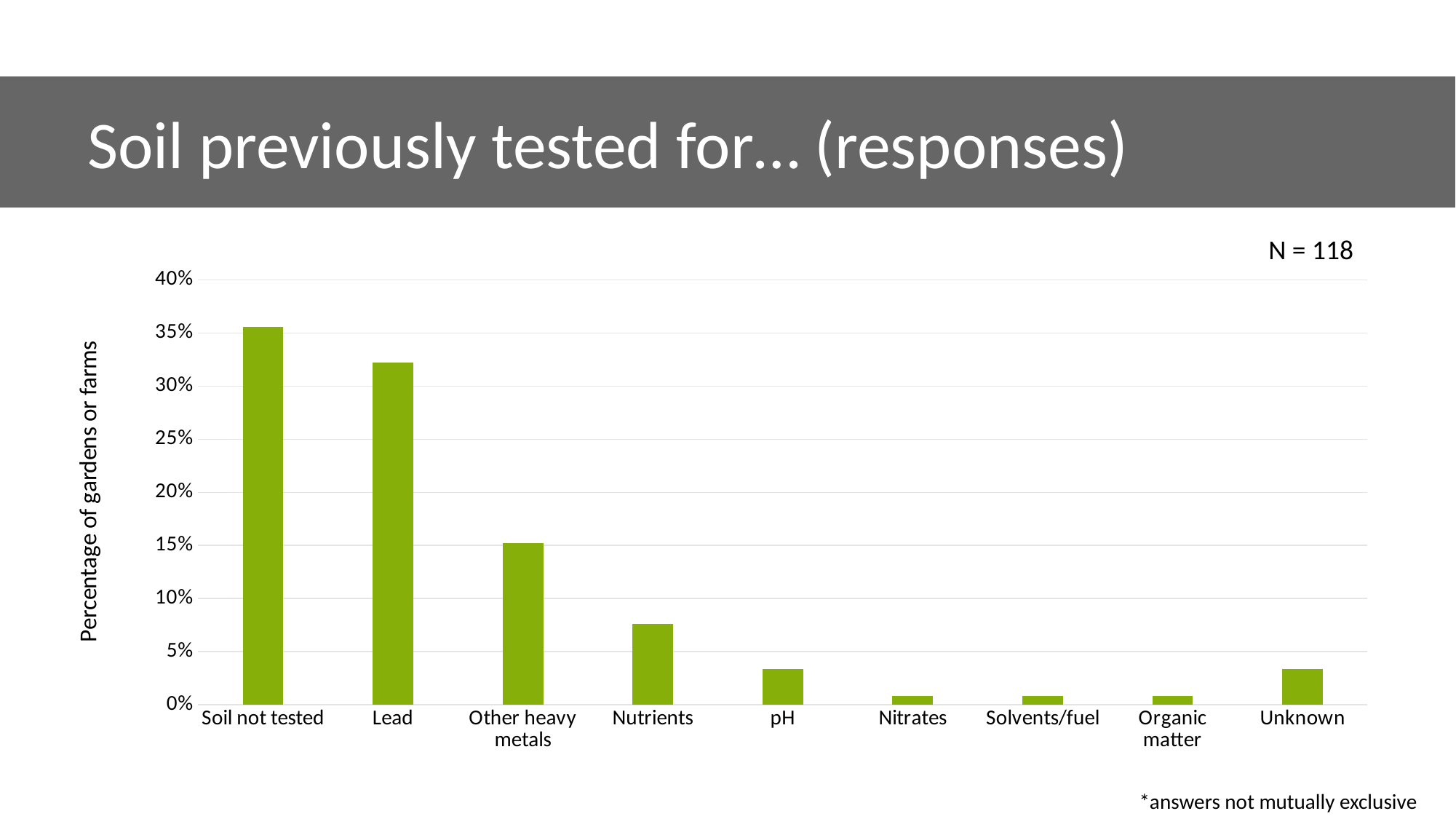
Which has a larger value, Nutrients or Nitrates? Nutrients Is the value for Lead greater or less than 30%? greater What is the label of the vertical axis of the chart? Percentage of gardens or farms Which has a larger value, Lead or Other heavy metals? Lead What sample size (N) is shown on the slide? N = 118 How many categories are shown on the x axis of the chart? 9 Is the value for Other heavy metals greater or less than 20%? less Is the value for pH greater or less than 5%? less Which category has the highest value in the chart? Soil not tested What kind of chart is shown on the slide? Bar chart